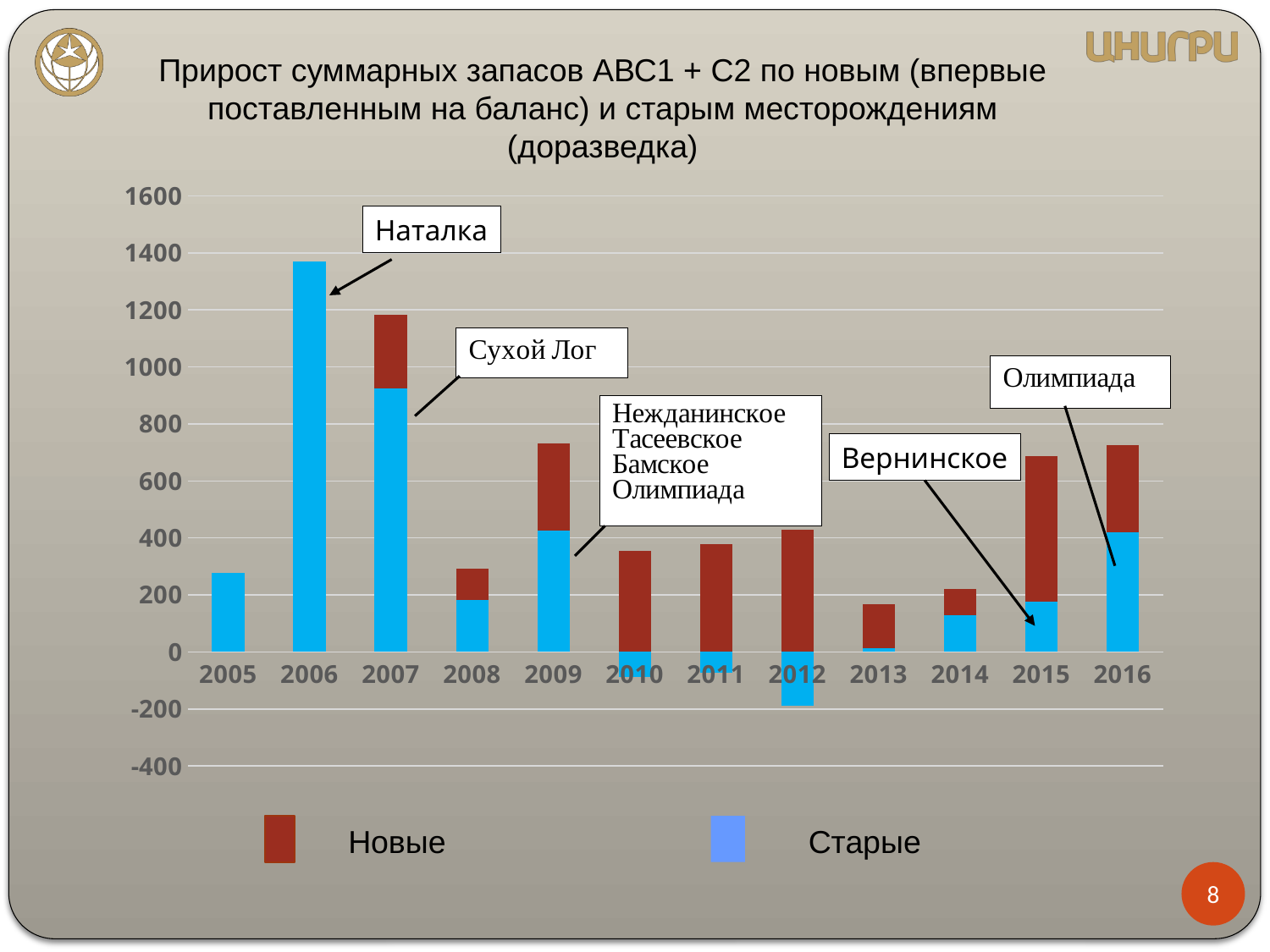
What kind of chart is shown on the slide? bar chart Is the total bar height for 2013 greater or less than 200? less Is the Старые value for 2012 greater or less than 0? less Do the bar heights rise or fall from 2006 to 2008? fall Which year has the tallest bar in the chart? 2006 How many years are shown on the x axis of the chart? 12 How many series does the legend list? 2 Which year has the lowest total bar height in the chart? 2013 Is the value for 2006 greater or less than 1200? greater Which series is shown in red in the legend? Новые Which year has the taller bar, 2006 or 2007? 2006